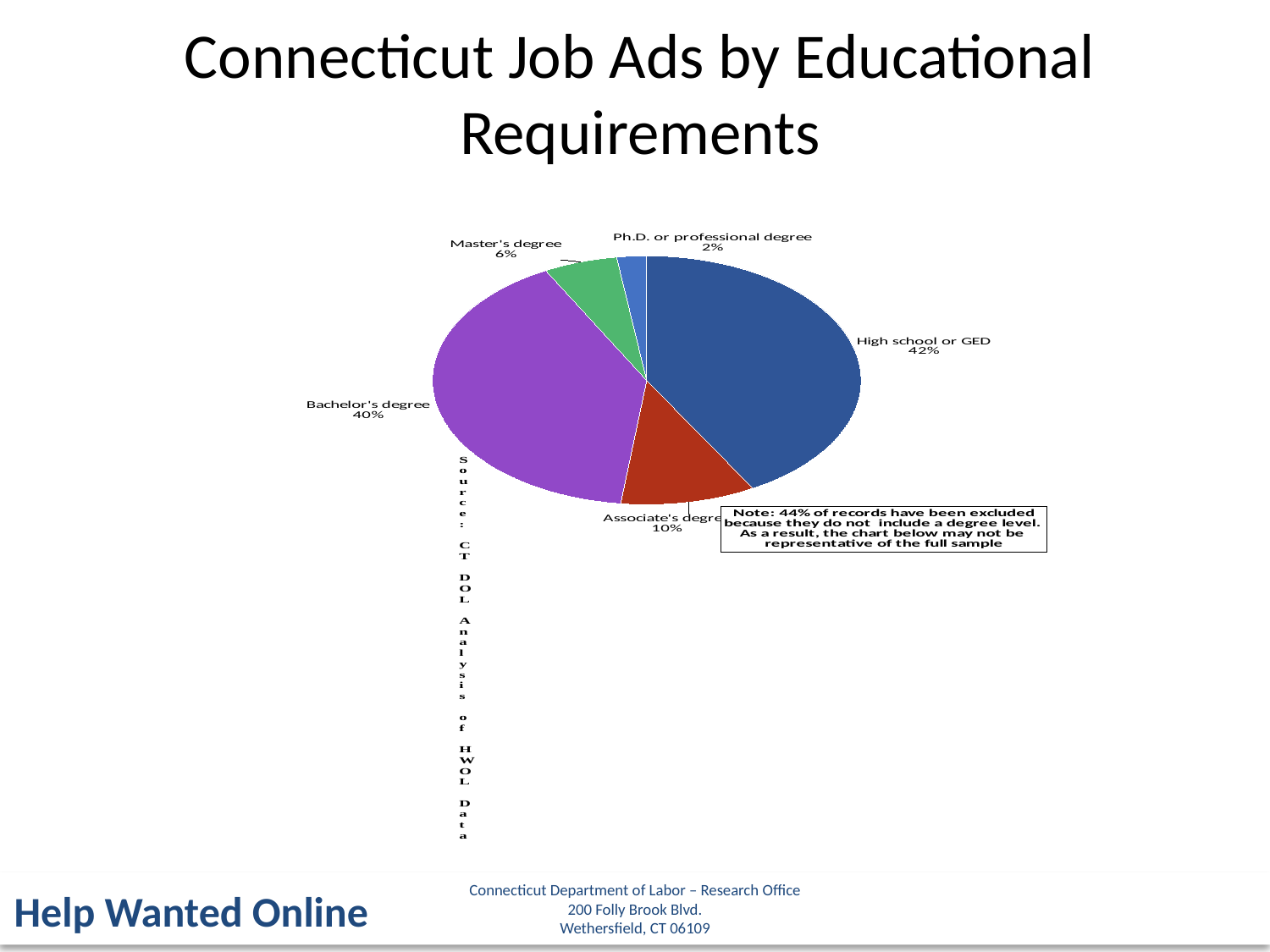
What percentage of job ads require a Bachelor's degree? 40% What percentage of job ads require a Ph.D. or professional degree? 2% What type of chart is shown on the slide? Pie chart What percentage of job ads require a Master's degree? 6% Which is larger: the share for Master's degree or the share for Associate's degree? Associate's degree What percentage of job ads require an Associate's degree? 10% How many educational requirement categories are shown in the pie chart? 5 Which educational requirement has the largest share of job ads? High school or GED Which educational requirement has the smallest share of job ads? Ph.D. or professional degree What share of Connecticut job ads require a high school diploma or GED? 42% According to the note on the slide, what percentage of records were excluded because they did not include a degree level? 44% What is the difference in percentage points between the Bachelor's degree share and the Associate's degree share? 30